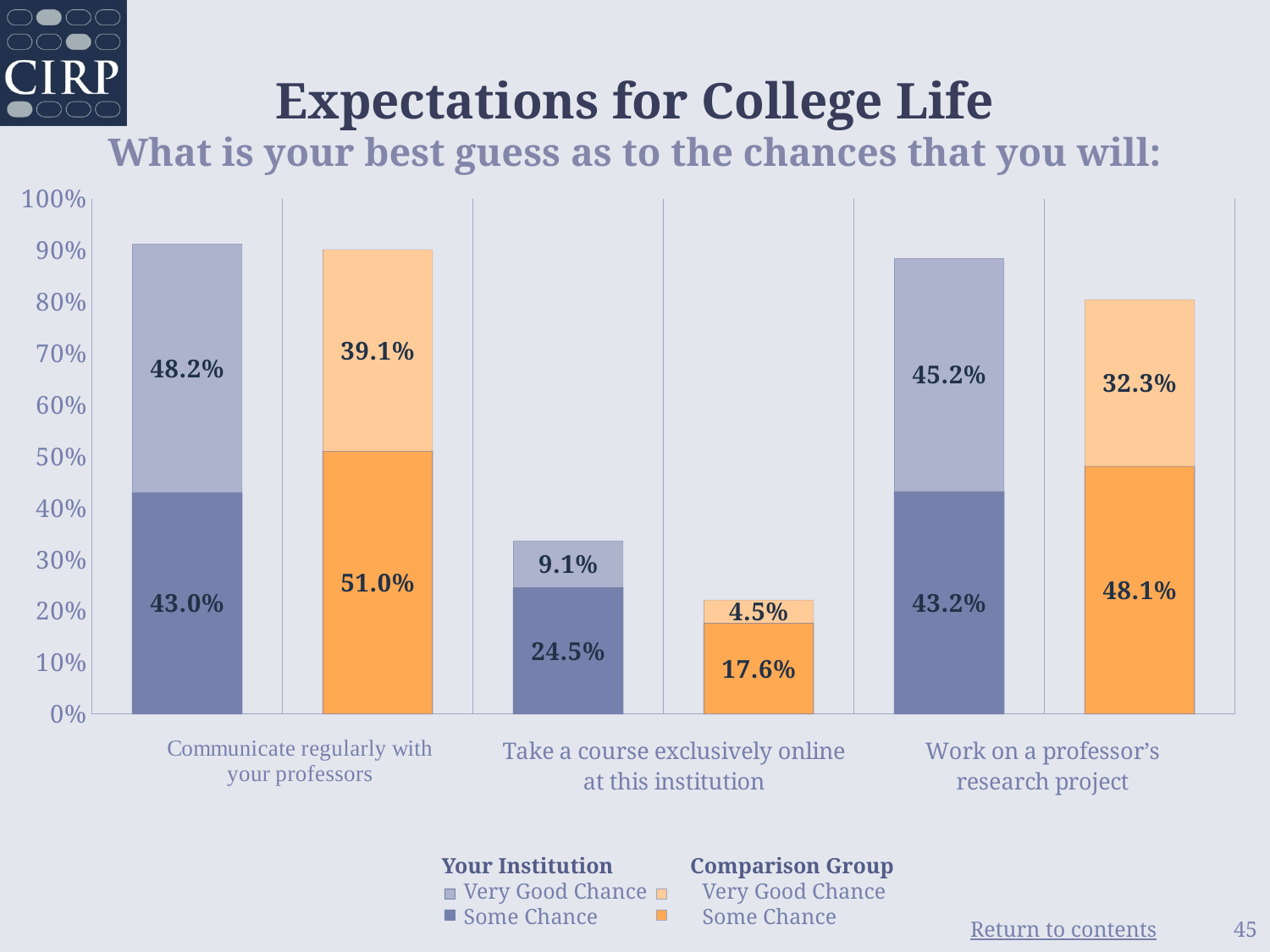
What is the difference between the Your Institution and Comparison Group "Very Good Chance" values for "Communicate regularly with your professors"? 9.1% How many categories are shown on the x axis? 3 What is the Comparison Group "Very Good Chance" value for "Work on a professor's research project"? 32.3% What is the total height of the Comparison Group stacked bar for "Work on a professor's research project"? 80.4% How many series does the legend list? 4 Which category has the lowest Comparison Group "Very Good Chance" value? Take a course exclusively online at this institution What is the Comparison Group "Some Chance" value for "Take a course exclusively online at this institution"? 17.6% What is the Your Institution "Very Good Chance" value for "Communicate regularly with your professors"? 48.2% What kind of chart is shown on the slide? Stacked bar chart Which is larger for "Work on a professor's research project": the Your Institution "Some Chance" value or the Comparison Group "Some Chance" value? Comparison Group "Some Chance" (48.1%) What is the Your Institution "Some Chance" value for "Work on a professor's research project"? 43.2% What is the total height of the Your Institution stacked bar for "Take a course exclusively online at this institution"? 33.6%